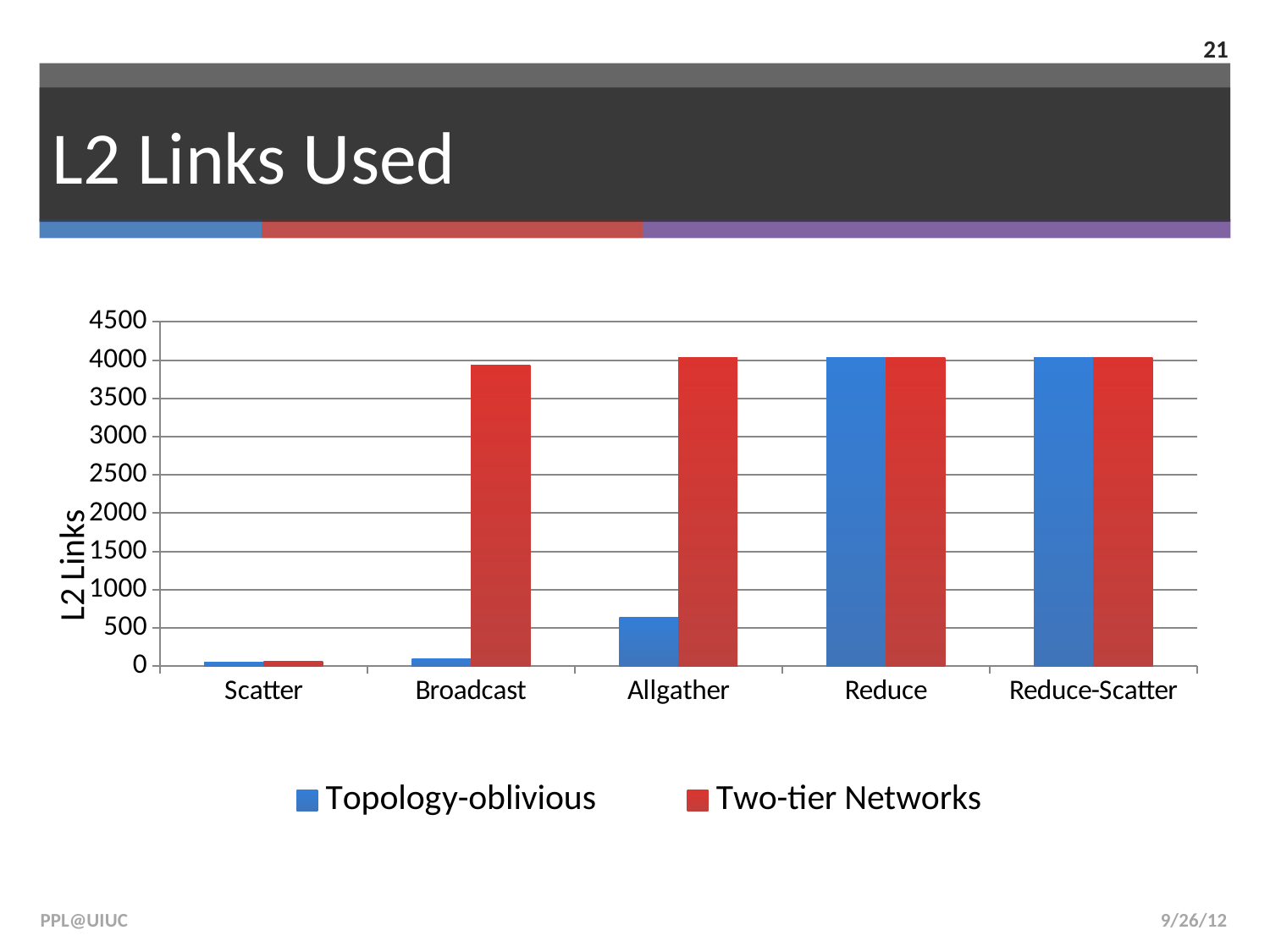
For Allgather, which series has the larger value, Topology-oblivious or Two-tier Networks? Two-tier Networks For Broadcast, which series has the larger value, Topology-oblivious or Two-tier Networks? Two-tier Networks How many series does the chart's legend list? 2 What are the two series named in the legend? Topology-oblivious and Two-tier Networks Which category has the lowest Two-tier Networks value? Scatter Is the Two-tier Networks value for Broadcast greater or less than 3500? greater Is the Topology-oblivious value for Reduce greater or less than 3500? greater What is the label on the vertical axis of the chart? L2 Links Is the Topology-oblivious value for Broadcast greater or less than 500? less How many categories are shown on the x axis of the chart? 5 What kind of chart is shown on the slide? bar chart